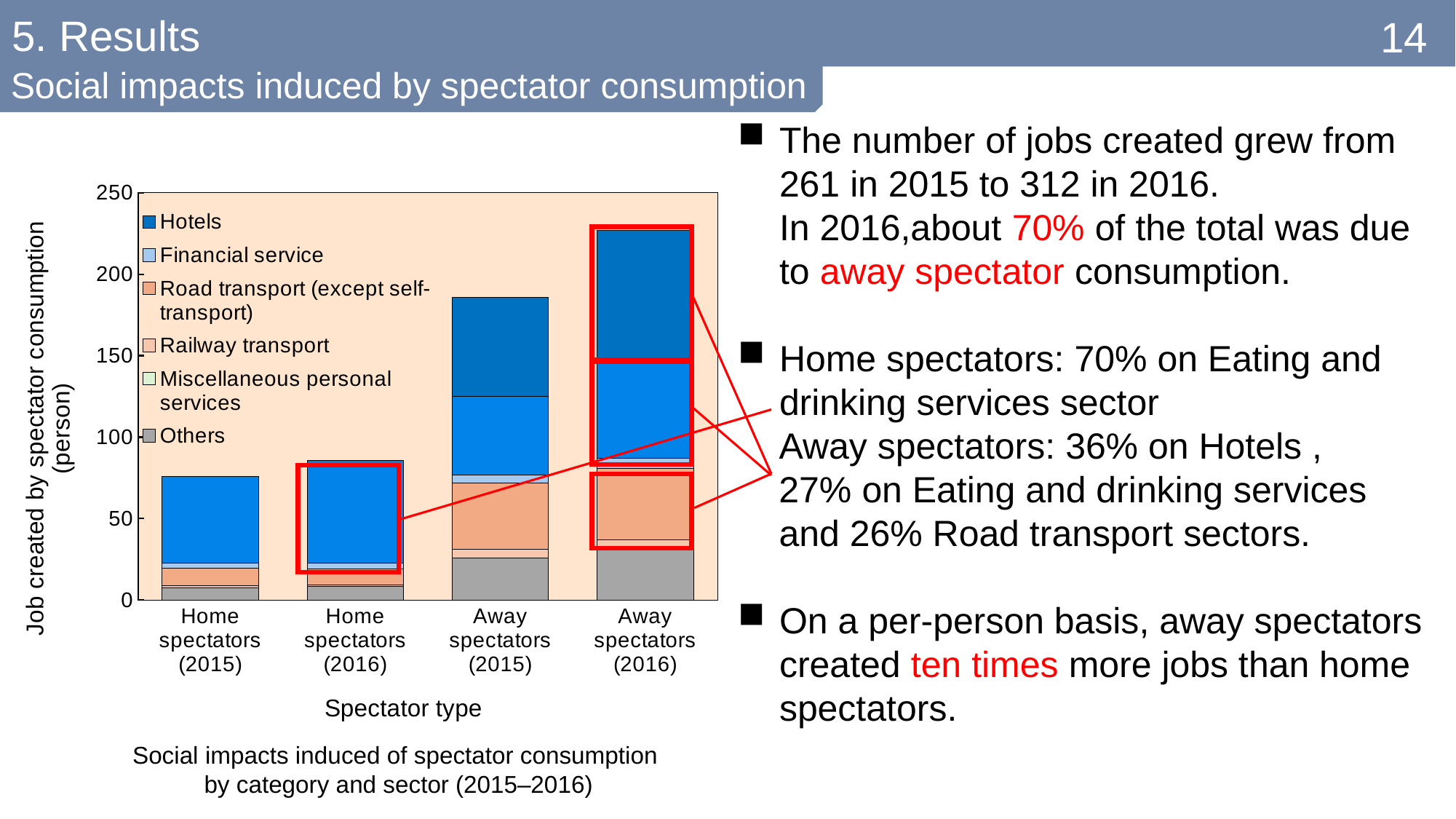
How many spectator-type categories are plotted on the x axis? 4 How many series does the chart's legend list? 6 Is the total bar for Away spectators (2016) greater or less than 200? greater Is the total bar for Away spectators (2015) greater or less than 150? greater Which bar is taller: Away spectators (2015) or Home spectators (2016)? Away spectators (2015) Is the total bar for Home spectators (2016) greater or less than 50? greater Do the total bar heights rise or fall from left to right along the x axis? rise Which spectator type has the shortest stacked bar? Home spectators (2015) What kind of chart is shown on the slide? Stacked bar chart What is the label of the chart's y axis? Job created by spectator consumption (person) Which spectator type has the tallest stacked bar? Away spectators (2016)